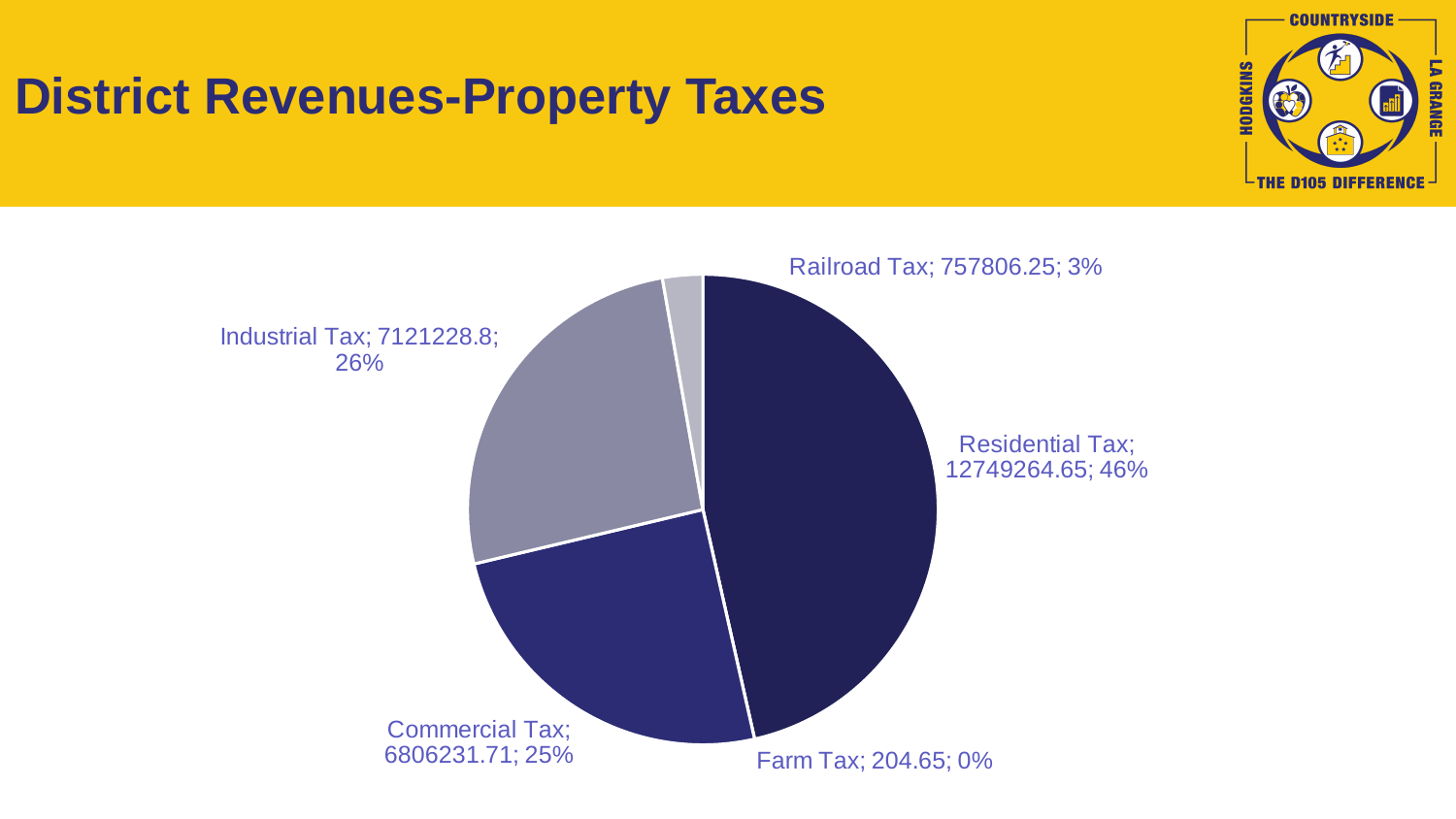
Which is larger, Industrial Tax or Commercial Tax? Industrial Tax What is the value for Railroad Tax? 757806.25 What share of the pie does Commercial Tax represent? 25% Which category has the smallest share of the pie? Farm Tax How many categories are shown in the pie chart? 5 What is the value for Residential Tax? 12749264.65 What is the value for Farm Tax? 204.65 What is the value for Industrial Tax? 7121228.8 Which category has the largest share of the pie? Residential Tax What is the difference between the Industrial Tax and Commercial Tax values? 314997.09 What kind of chart is shown on the slide? pie chart What share of the pie does Industrial Tax represent? 26%